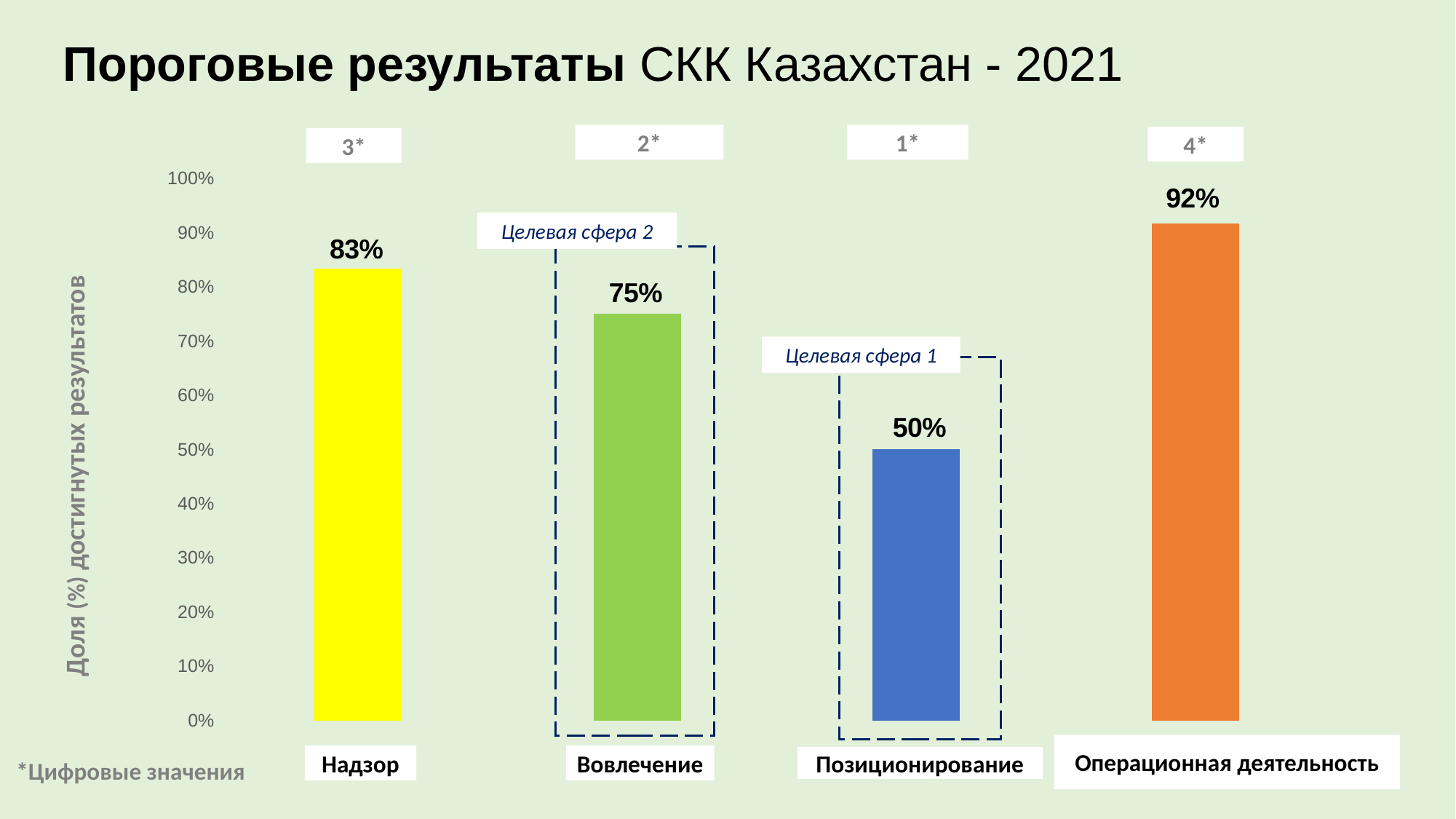
Which is larger, the value for Надзор or the value for Вовлечение? Надзор What is the value for Надзор? 83% What is the value for Операционная деятельность? 92% Which category has the highest value? Операционная деятельность What is the value for Вовлечение? 75% What kind of chart is shown on the slide? Bar chart What is the difference between the values for Надзор and Вовлечение? 8% How many categories are shown in the chart? 4 Which category has the lowest value? Позиционирование What is the difference between the values for Операционная деятельность and Позиционирование? 42% What is the title of the slide? Пороговые результаты СКК Казахстан - 2021 What is the value for Позиционирование? 50%